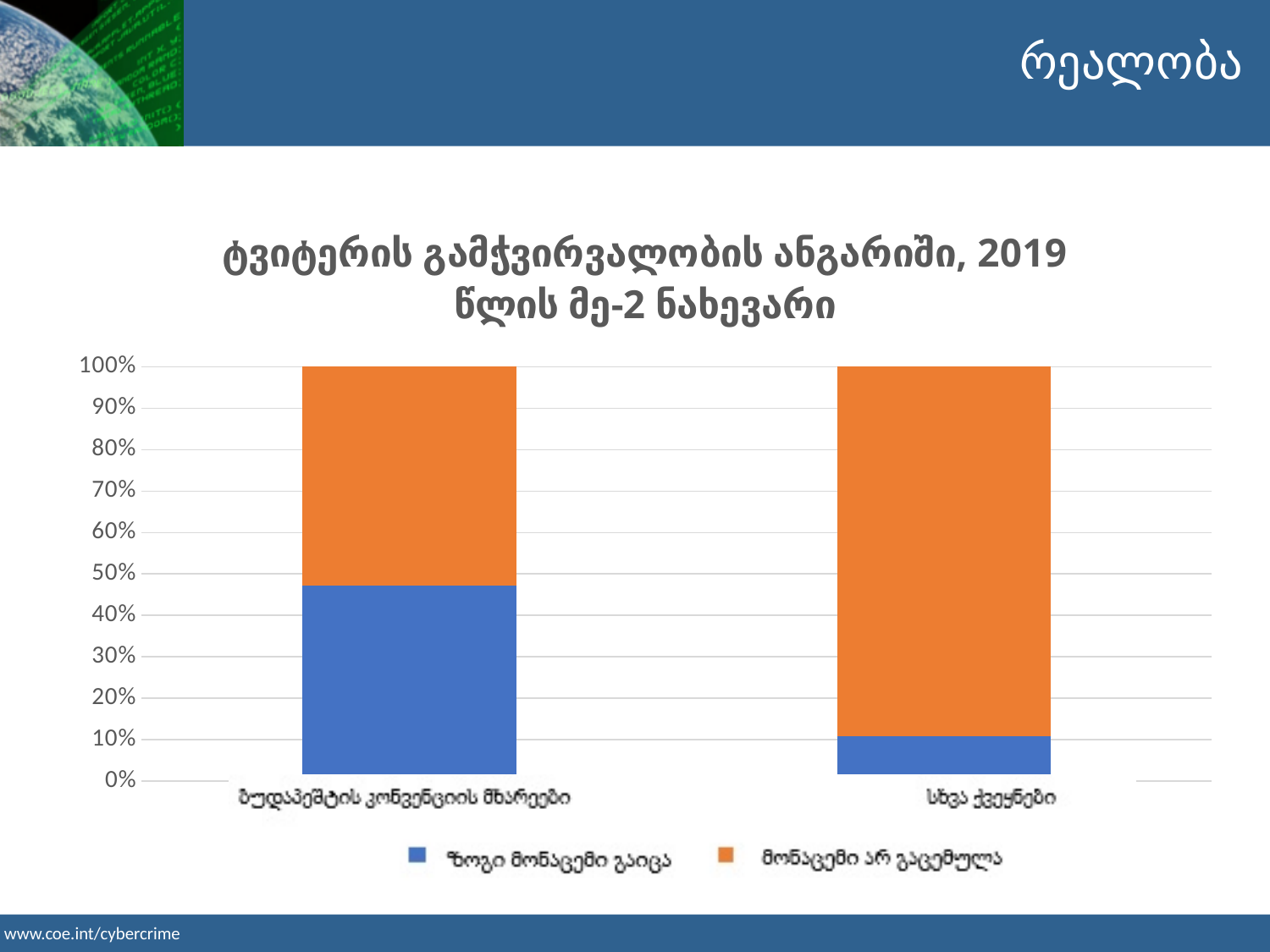
How many series does the chart legend list? 2 What is the title of the chart? ტვიტერის გამჭვირვალობის ანგარიში, 2019 წლის მე-2 ნახევარი Is the value of ზოგი მონაცემი გაიცა for ბუდაპეშტის კონვენციის მხარეები greater or less than 50%? less What type of chart is shown on the slide? stacked bar chart Which category has the highest value for მონაცემი არ გაცემულა? სხვა ქვეყნები Is the value of ზოგი მონაცემი გაიცა for ბუდაპეშტის კონვენციის მხარეები greater or less than 40%? greater Which series is shown in blue in the chart? ზოგი მონაცემი გაიცა Which category has the larger value for ზოგი მონაცემი გაიცა: ბუდაპეშტის კონვენციის მხარეები or სხვა ქვეყნები? ბუდაპეშტის კონვენციის მხარეები How many categories are shown on the x axis of the chart? 2 Is the value of ზოგი მონაცემი გაიცა for სხვა ქვეყნები greater or less than 20%? less What is the total height of the stacked bar for სხვა ქვეყნები? 100%